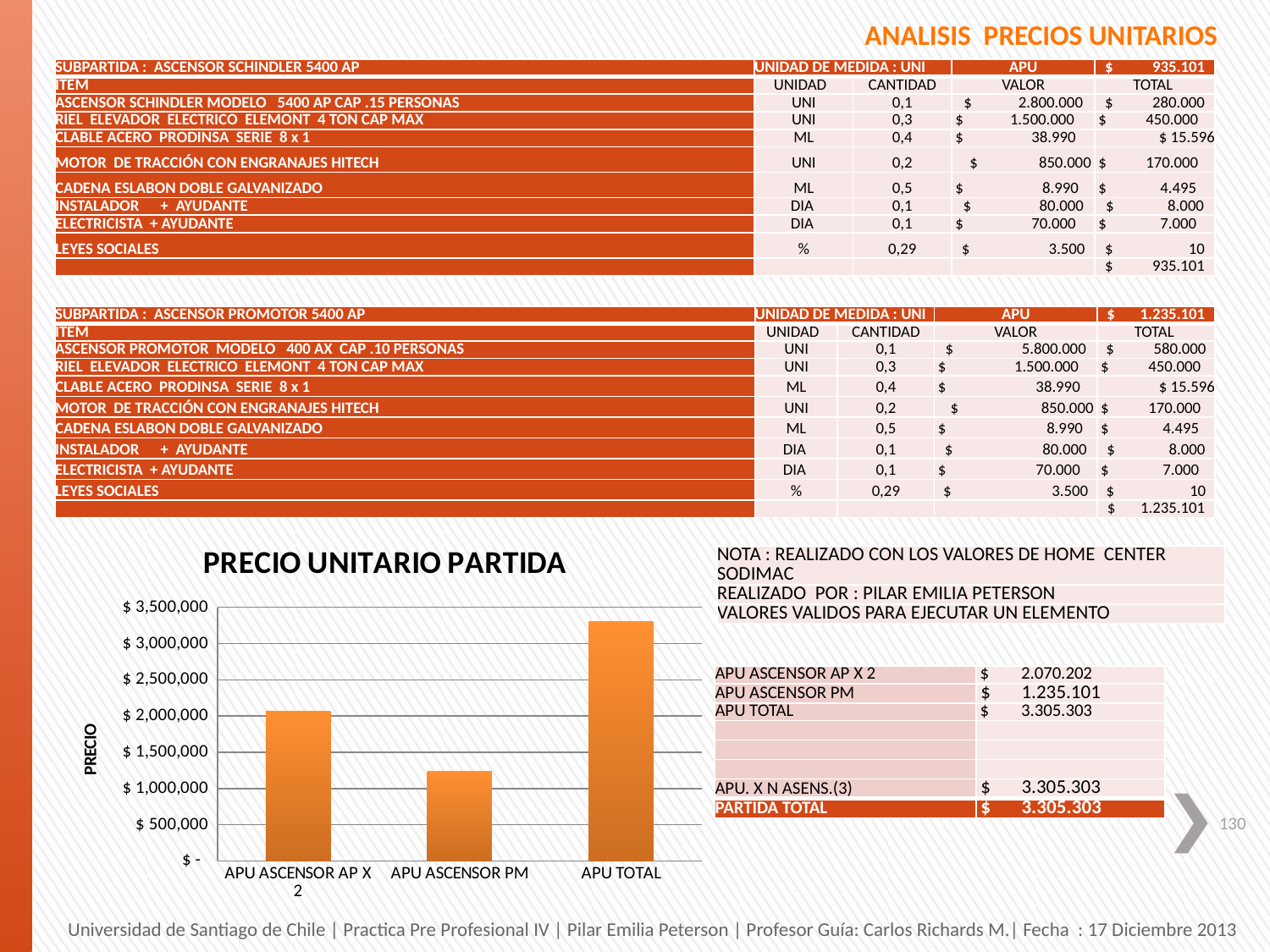
Is the value for APU ASCENSOR PM greater or less than $ 1,500,000? less Which category has the lowest bar in the PRECIO UNITARIO PARTIDA chart? APU ASCENSOR PM Is the value for APU ASCENSOR PM greater or less than $ 1,000,000? greater Is the value for APU ASCENSOR AP X 2 greater or less than $ 2,500,000? less Which category has the highest bar in the PRECIO UNITARIO PARTIDA chart? APU TOTAL What is the label on the vertical axis of the PRECIO UNITARIO PARTIDA chart? PRECIO In the PRECIO UNITARIO PARTIDA chart, which is larger: APU ASCENSOR AP X 2 or APU ASCENSOR PM? APU ASCENSOR AP X 2 What is the title of the chart on the slide? PRECIO UNITARIO PARTIDA How many categories are plotted in the PRECIO UNITARIO PARTIDA chart? 3 What type of chart is shown under the title PRECIO UNITARIO PARTIDA? bar chart